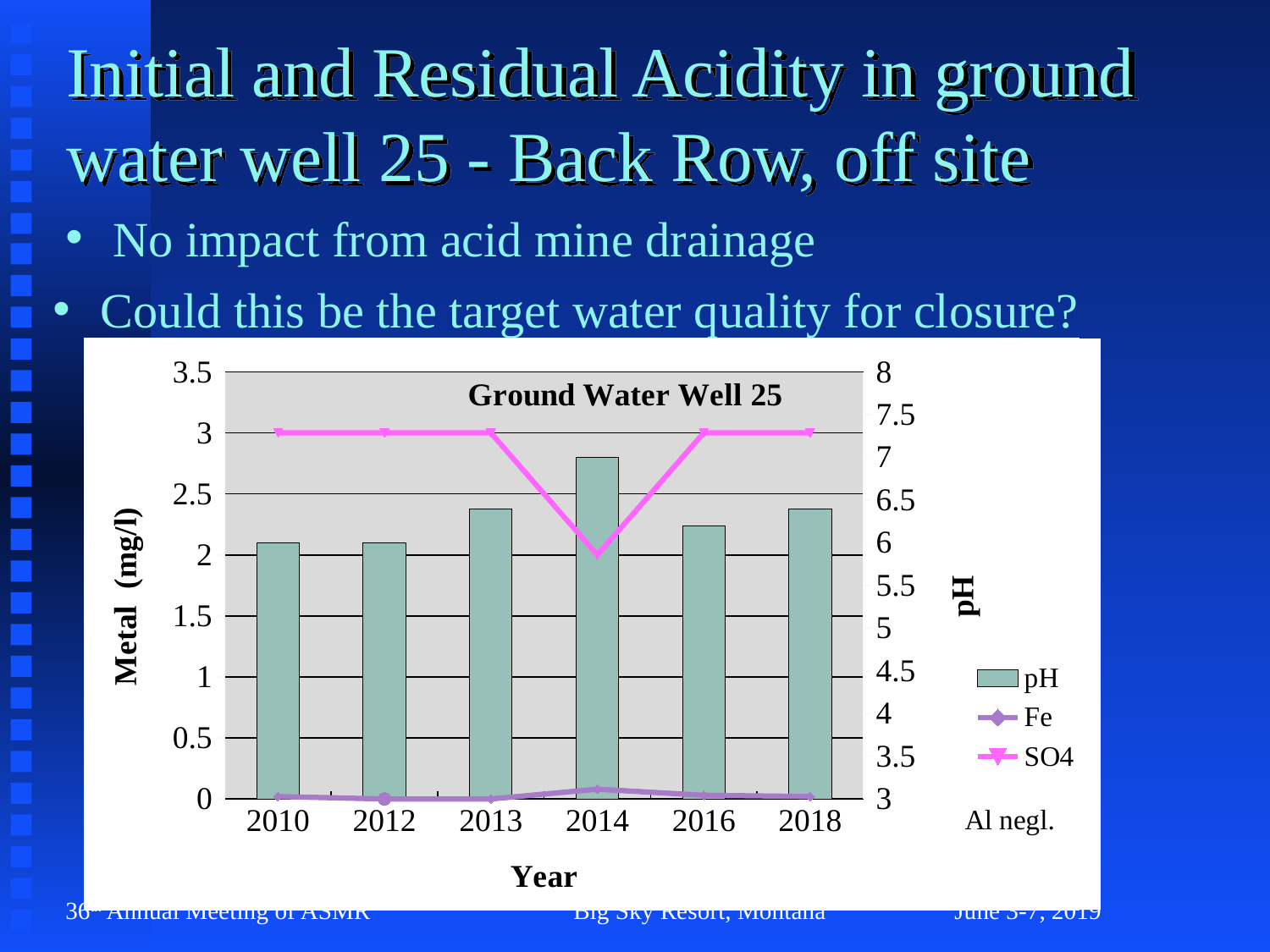
Is the bar for 2014 taller or shorter than the bar for 2010? taller Which series are listed in the chart legend? pH, Fe, SO4 In which year does the SO4 line reach its lowest point? 2014 What kind of chart is shown on the slide? Combination bar and line chart What is the label of the x axis of the chart? Year How many series does the chart legend list? 3 Which year has the tallest bar in the chart? 2014 Is the SO4 point for 2014 greater or less than 2.5 on the left Metal (mg/l) axis? less Is the bar for 2014 greater or less than 2.5 on the left Metal (mg/l) axis? greater What is the title of the chart? Ground Water Well 25 Is the bar for 2010 greater or less than 2.5 on the left Metal (mg/l) axis? less How many years are shown on the x axis of the chart? 6